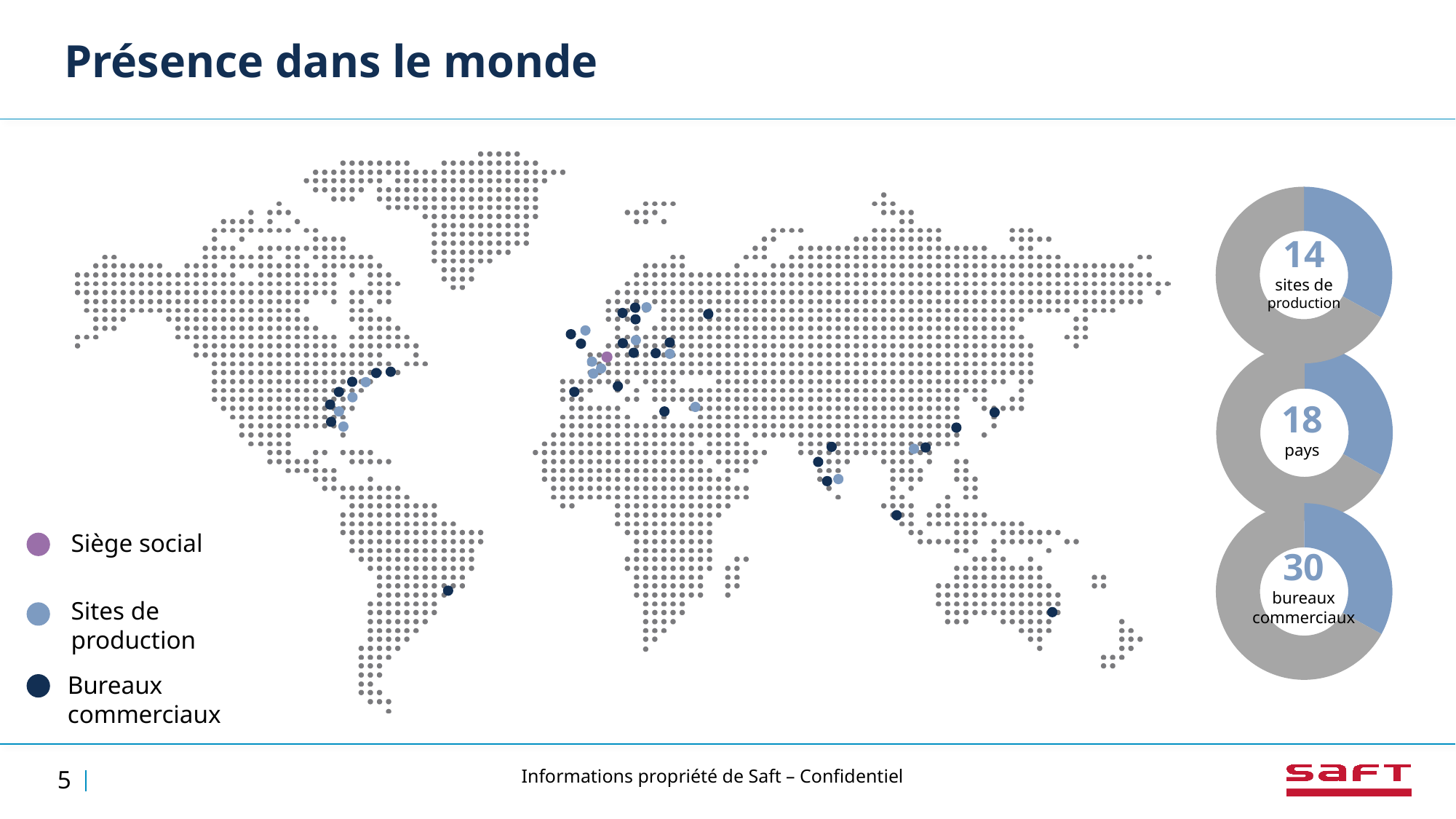
What kind of charts are the three circular graphics on the right side of the slide? Donut (pie) charts What is the title of the slide containing the world map and donut charts? Présence dans le monde Among the three donut charts on the right, which category has the lowest number? sites de production How many entries does the legend of the world map list? 3 On the middle donut chart on the right, how many pays (countries) are shown? 18 Using the donut charts on the right, what is the difference between the number of pays and the number of sites de production? 4 Among the three donut charts on the right, which category has the highest number? bureaux commerciaux Using the donut charts on the right, what is the difference between the number of bureaux commerciaux and the number of sites de production? 16 On the bottom donut chart on the right, what number is shown for bureaux commerciaux? 30 How many donut charts are shown on the right side of the slide? 3 On the top donut chart on the right, what number is shown for sites de production? 14 On the donut charts on the right, which is larger: the number of pays or the number of sites de production? pays